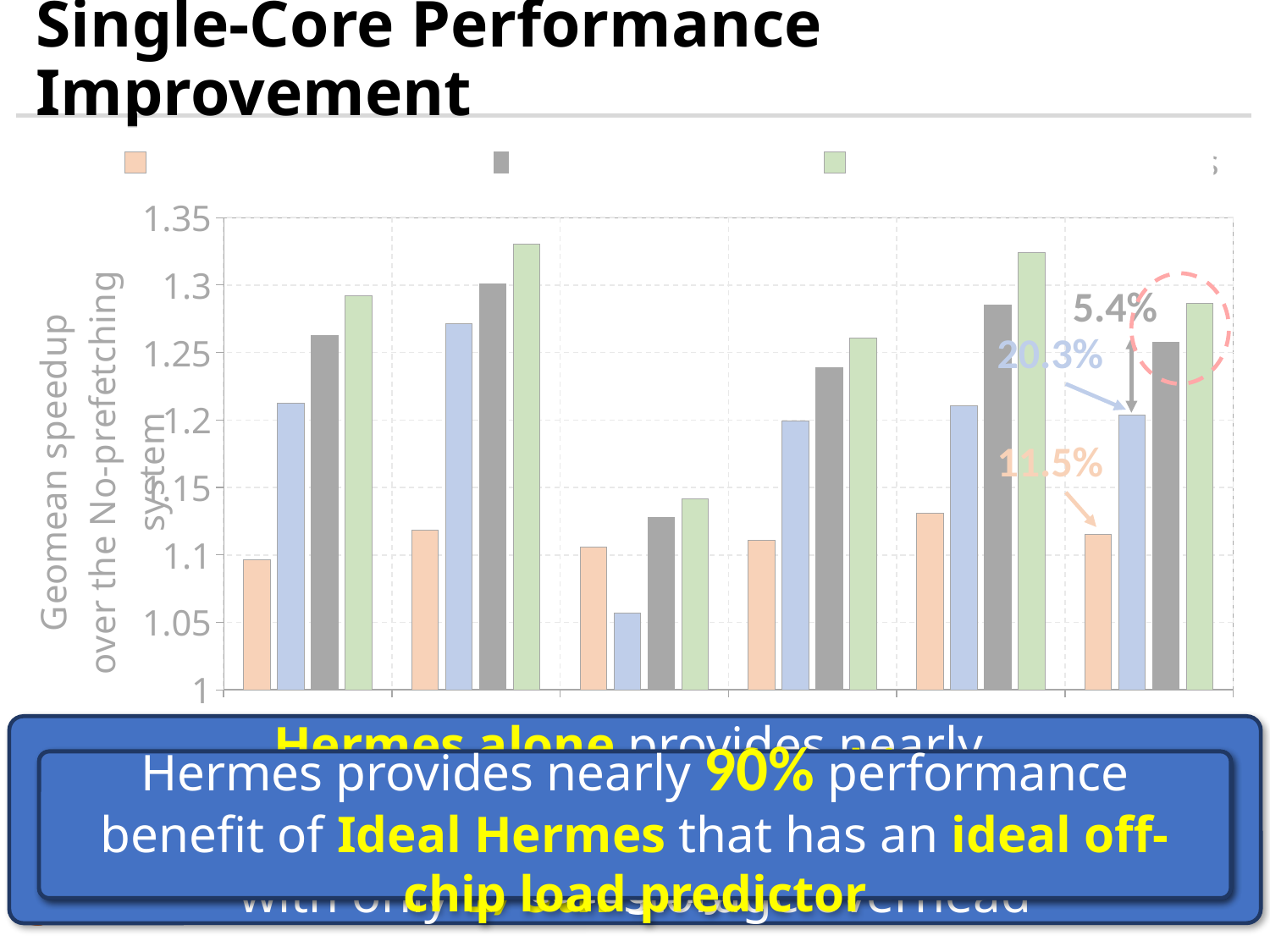
In the fifth group from the left, is the value of the gray bar greater or less than 1.25? greater In the leftmost group, is the value of the green bar greater or less than 1.25? greater Which colour bar is the tallest in the leftmost group? green How many groups of bars are plotted along the x axis? 6 What percentage annotation points to the blue bar in the rightmost group? 20.3% What is the label of the y axis? Geomean speedup over the No-prefetching system Which colour bar is the lowest in the third group from the left? blue In the fourth group from the left, is the value of the orange bar greater or less than 1.15? less In the rightmost group, which is taller, the gray bar or the green bar? green How many bars are there in each group? 4 What kind of chart is shown on the slide? bar chart